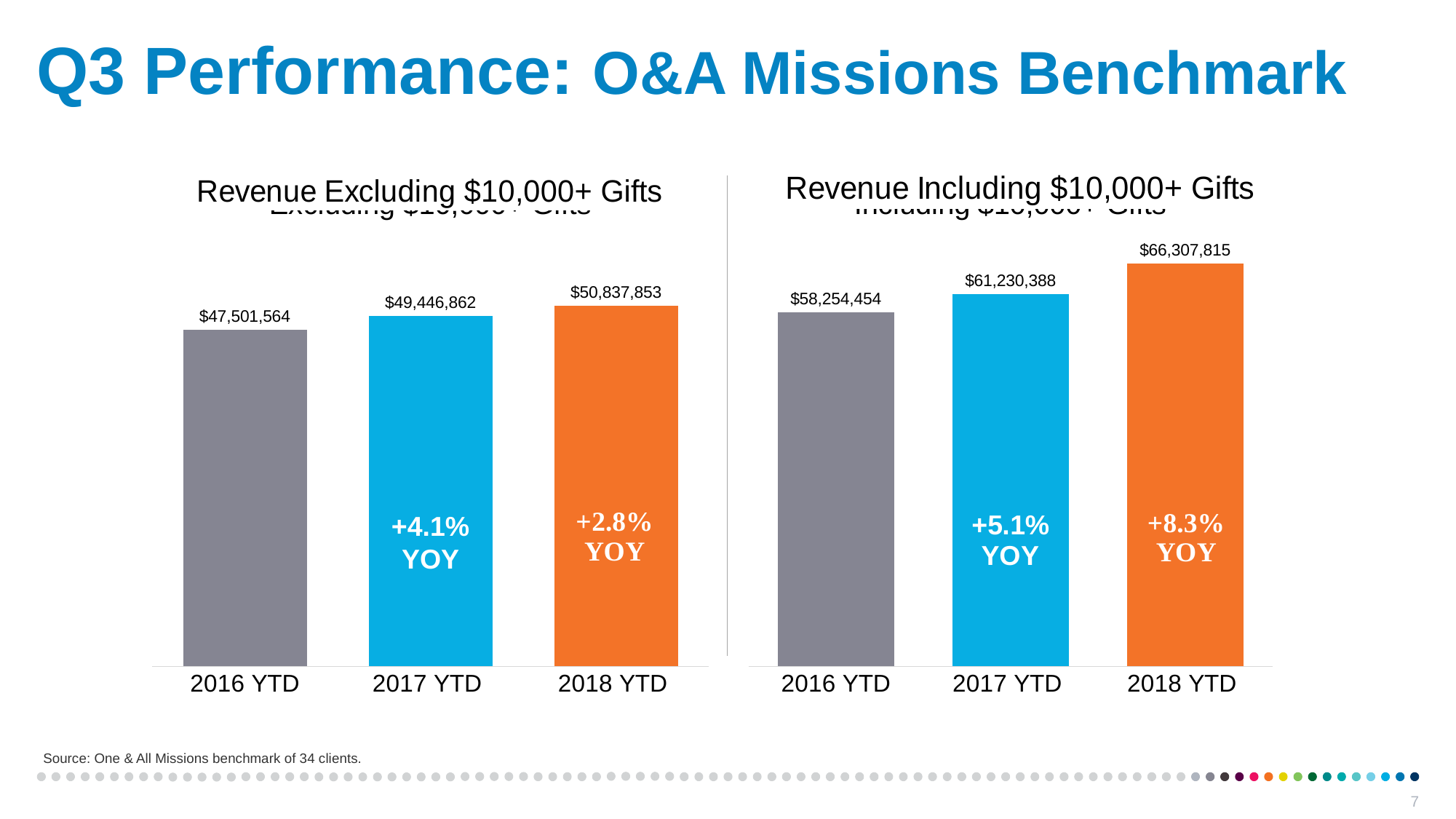
In the 'Revenue Excluding $10,000+ Gifts' chart, which year has the lowest revenue? 2016 YTD In the 'Revenue Including $10,000+ Gifts' chart, which year has the highest revenue? 2018 YTD In the 'Revenue Including $10,000+ Gifts' chart, what is the value for 2017 YTD? $61,230,388 In the 'Revenue Including $10,000+ Gifts' chart, what YOY change is printed on the 2018 YTD bar? +8.3% YOY In the 'Revenue Excluding $10,000+ Gifts' chart, what is the difference between the 2018 YTD and 2016 YTD values? $3,336,289 What kind of chart is the 'Revenue Including $10,000+ Gifts' chart? Bar chart In the 'Revenue Including $10,000+ Gifts' chart, what is the value for 2018 YTD? $66,307,815 In the 'Revenue Including $10,000+ Gifts' chart, what is the difference between the 2018 YTD and 2017 YTD values? $5,077,427 Which is larger: 2017 YTD revenue in the 'Revenue Excluding $10,000+ Gifts' chart or 2016 YTD revenue in the 'Revenue Including $10,000+ Gifts' chart? 2016 YTD in the Including chart In the 'Revenue Excluding $10,000+ Gifts' chart, what is the value for 2016 YTD? $47,501,564 How many categories are shown on the x axis of the 'Revenue Excluding $10,000+ Gifts' chart? 3 In the 'Revenue Excluding $10,000+ Gifts' chart, what is the value for 2018 YTD? $50,837,853